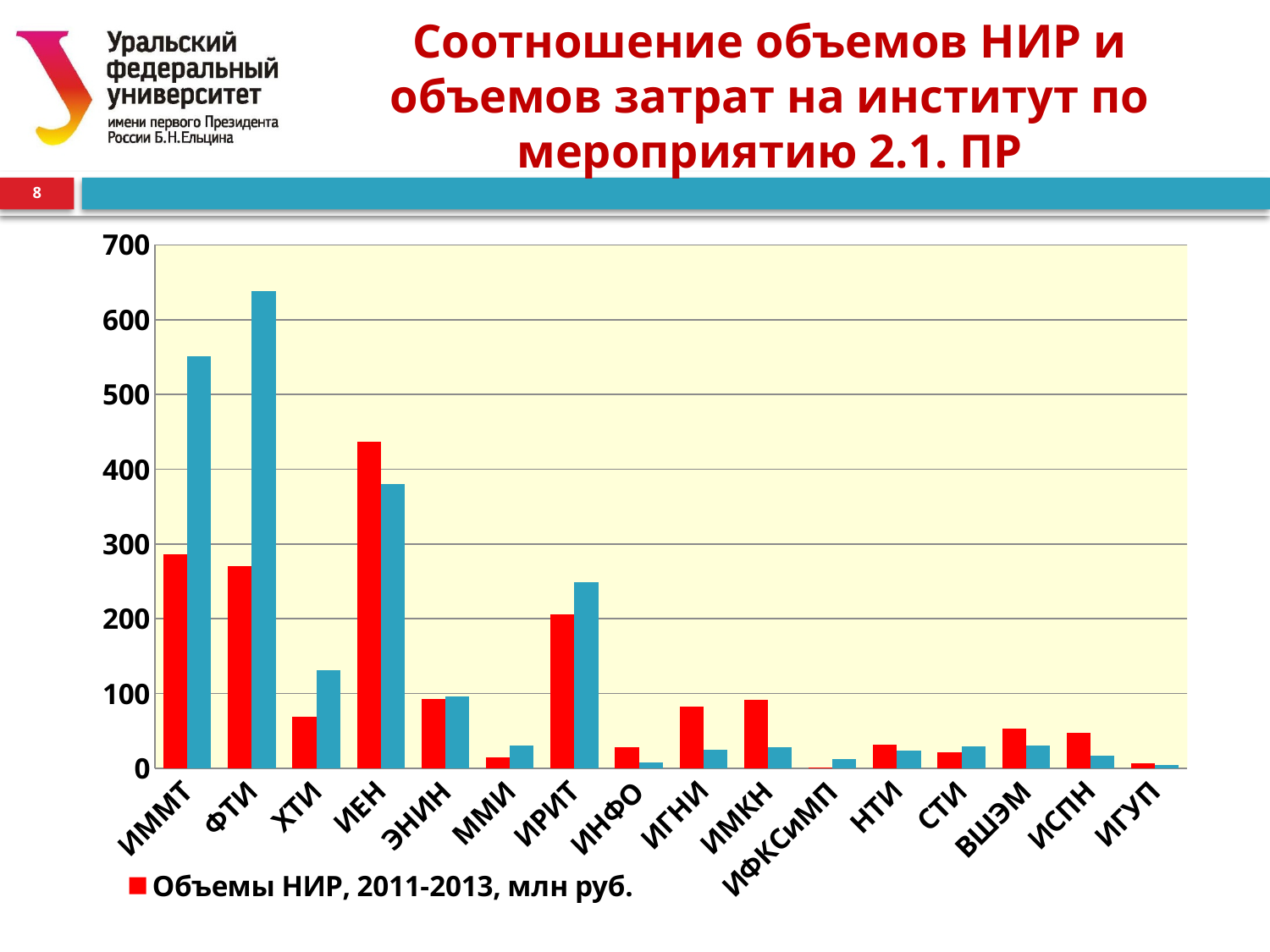
Which institute has the lowest red bar (Объемы НИР, 2011-2013)? ИФКСиМП How many series does the legend of the chart list? 1 What kind of chart is shown on the slide? bar chart What is the legend entry shown for the red series? Объемы НИР, 2011-2013, млн руб. Is the blue bar for ИММТ greater or less than 500? greater Is the red bar (Объемы НИР) for ИЕН greater or less than 400? greater How many institutes (categories) are shown on the x axis of the chart? 16 Is the red bar (Объемы НИР) for ХТИ greater or less than 100? less Which institute has the highest blue bar? ФТИ For ИЕН, which bar is larger, the red one or the blue one? red Which institute has the highest red bar (Объемы НИР, 2011-2013)? ИЕН